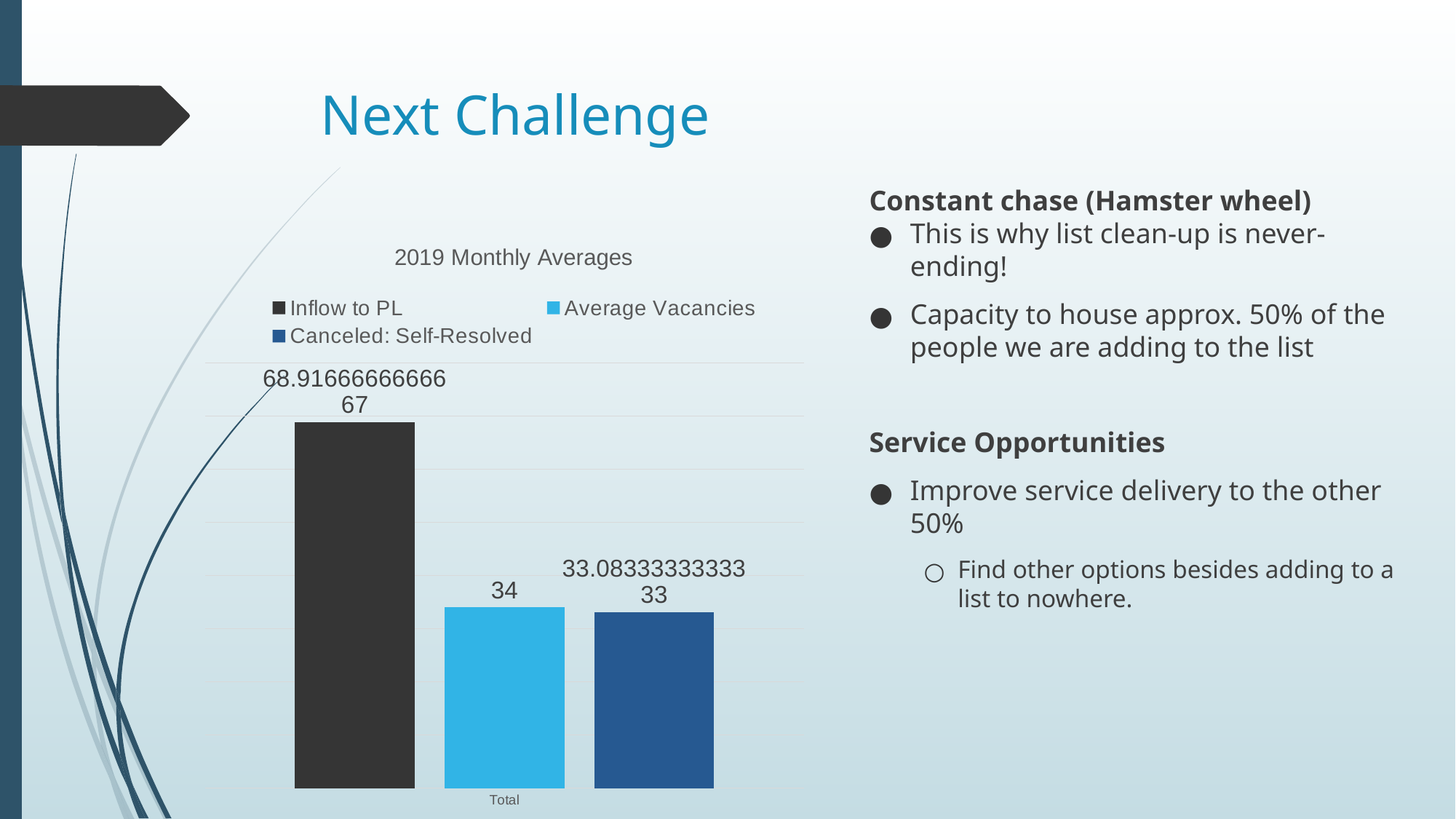
What is the title of the chart? 2019 Monthly Averages What is the value for Canceled: Self-Resolved? 33.0833333333333 What is the value for Average Vacancies? 34 Which series has the lowest value? Canceled: Self-Resolved How many series does the chart legend list? 3 How many bars are plotted in the chart? 3 What is the label of the category on the x axis? Total Which series has the highest value? Inflow to PL What is the difference between Inflow to PL and Average Vacancies? 34.9166666666667 What is the value for Inflow to PL? 68.9166666666667 Which is larger, Average Vacancies or Canceled: Self-Resolved? Average Vacancies What kind of chart is shown on the slide? bar chart